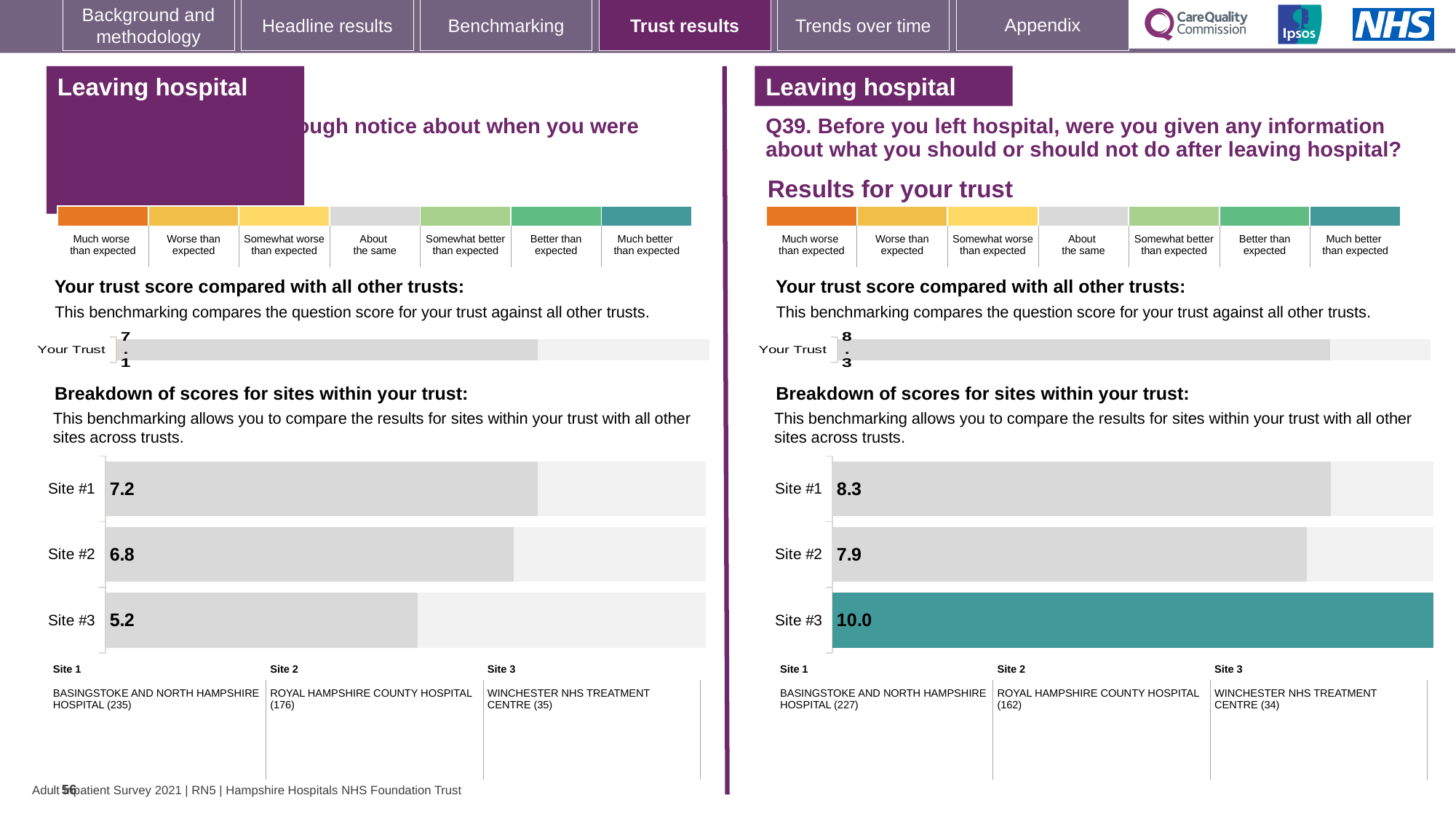
On the left-hand chart, what is the difference between the scores for Site #1 and Site #3? 2.0 How many sites are shown in the site breakdown chart on the right-hand side (Q39)? 3 On the right-hand chart (Q39), what is the 'Your Trust' score? 8.3 What kind of chart is used for the breakdown of scores for sites on the left-hand side? Bar chart On the left-hand chart, what is the score for Site #3? 5.2 On the right-hand chart (Q39), what is the score for Site #3? 10.0 On the right-hand chart (Q39), which is larger, the score for Site #1 or Site #2? Site #1 On the right-hand chart (Q39), what is the difference between the scores for Site #3 and Site #2? 2.1 On the left-hand chart, which site has the lowest score? Site #3 On the right-hand chart (Q39), which site has the highest score? Site #3 On the left-hand chart, what is the score for Site #1? 7.2 On the right-hand chart (Q39), what is the score for Site #2? 7.9